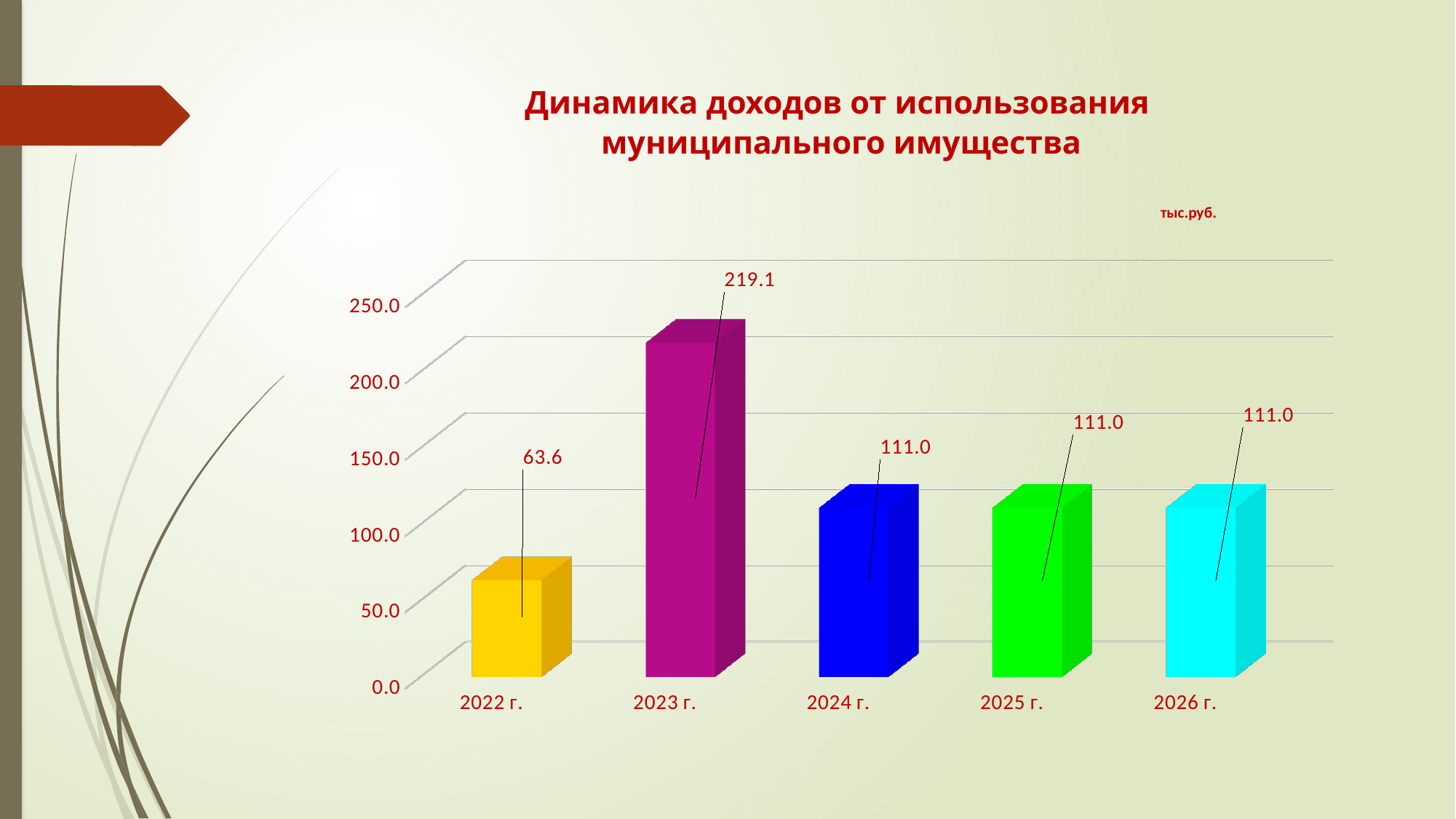
What is the value for 2025 г.? 111.0 Is the value for 2023 г. greater or less than 200.0? greater What is the value for 2022 г.? 63.6 Which is larger, the value for 2022 г. or the value for 2026 г.? 2026 г. What is the value for 2023 г.? 219.1 What unit is indicated above the chart? тыс.руб. Which year has the highest value? 2023 г. What is the difference between the values for 2023 г. and 2022 г.? 155.5 What is the difference between the values for 2023 г. and 2024 г.? 108.1 What kind of chart is shown on the slide? bar chart Which year has the lowest value? 2022 г. How many years are shown on the x axis? 5